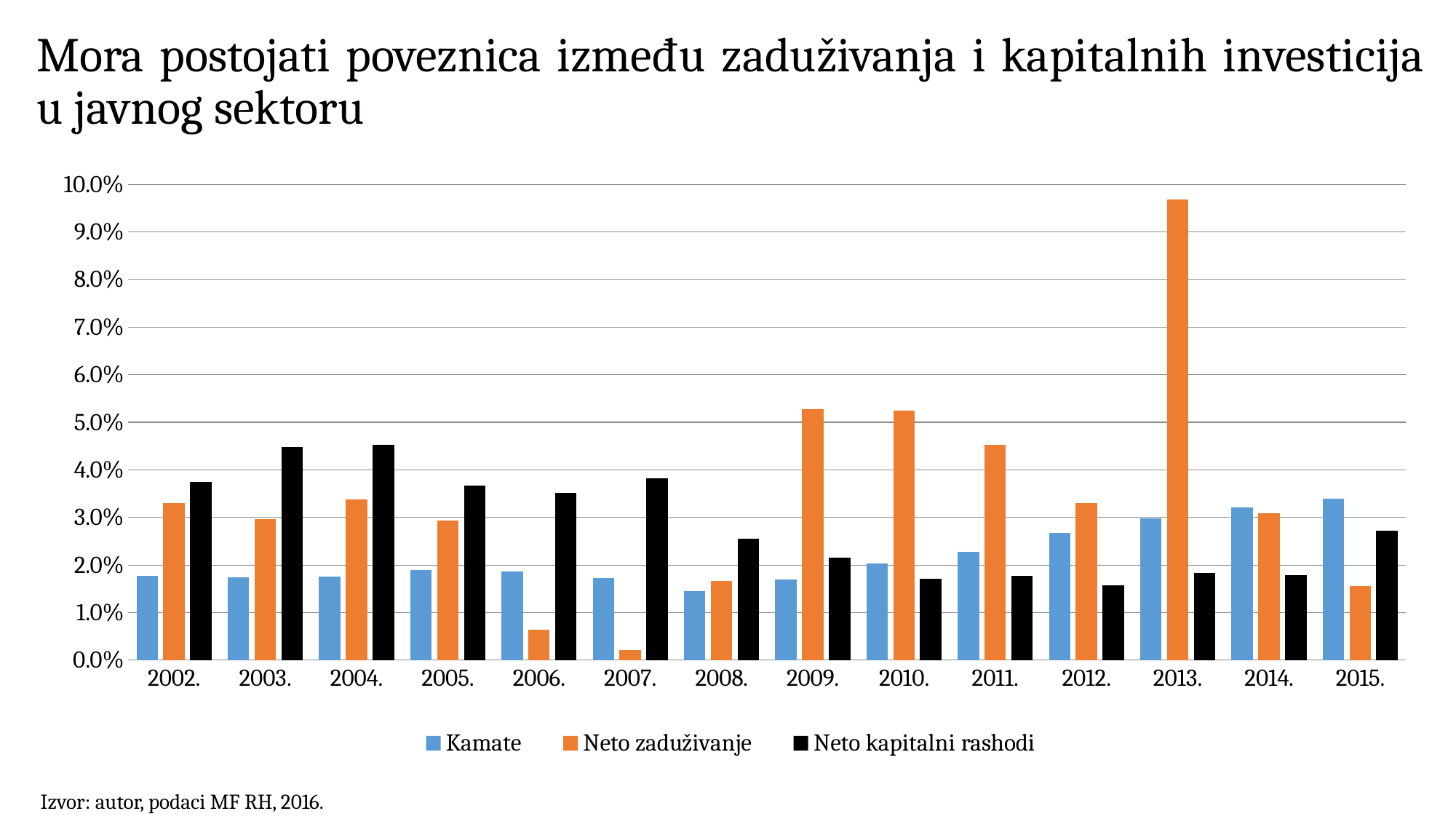
Is the value for Neto zaduživanje in 2006 greater or less than 1.0%? less In which year is Neto zaduživanje highest? 2013. How many years are shown on the x axis? 14 How many series does the legend list? 3 In 2002, which is larger: Kamate or Neto kapitalni rashodi? Neto kapitalni rashodi Do the Kamate values rise or fall from 2008 to 2015? rise In which year is Neto zaduživanje lowest? 2007. In which year is Kamate highest? 2015. Is the value for Neto kapitalni rashodi in 2004 greater or less than 4.0%? greater In 2015, which is larger: Kamate or Neto zaduživanje? Kamate What kind of chart is shown on the slide? bar chart Is the value for Neto zaduživanje in 2013 greater or less than 9.0%? greater